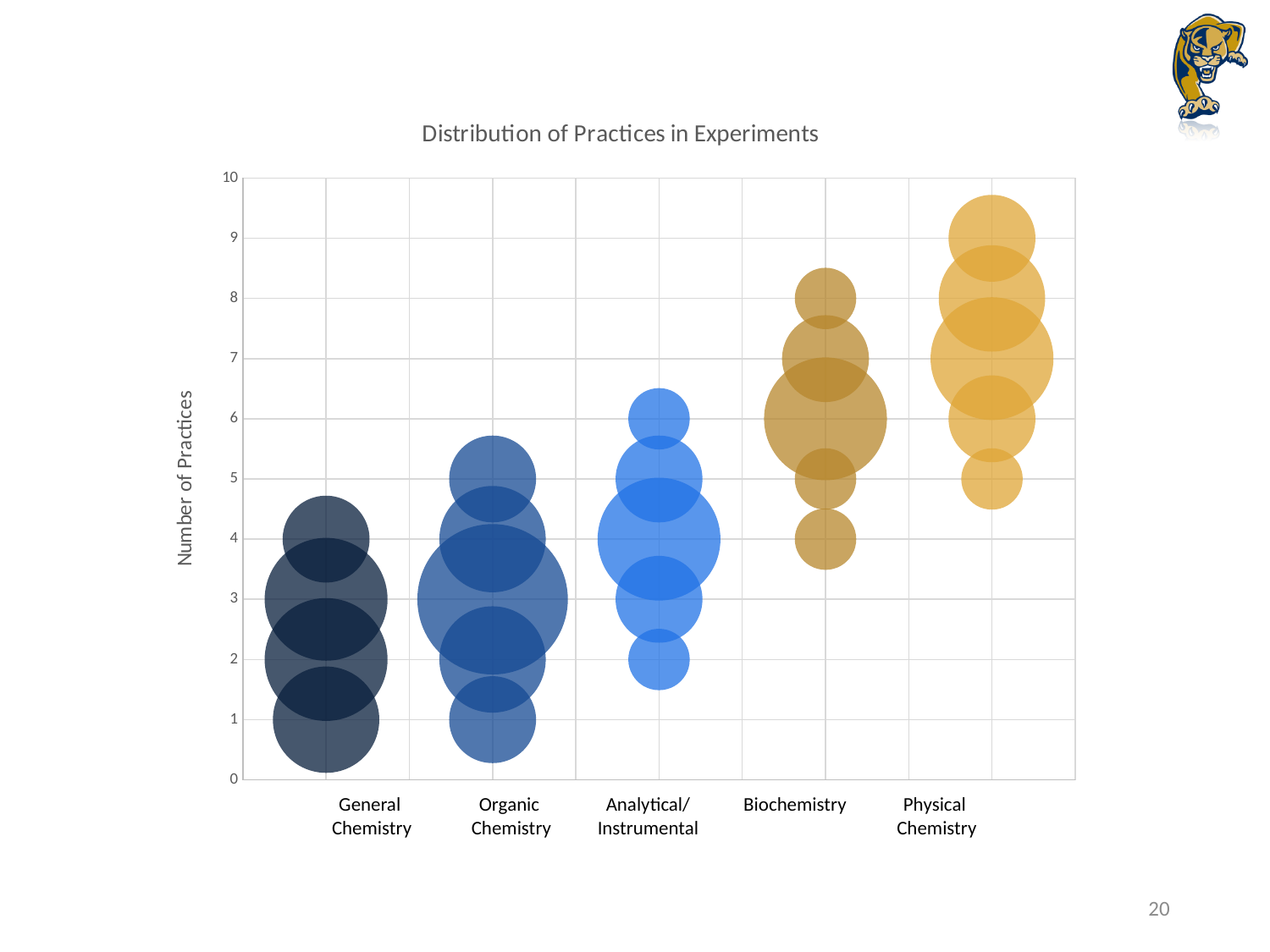
How many bubbles are plotted for Analytical/Instrumental? 5 What is the title of the chart? Distribution of Practices in Experiments What is the highest number of practices at which a bubble is plotted for Biochemistry? 8 Which category has the bubble plotted at the highest number of practices? Physical Chemistry What is the label of the vertical axis? Number of Practices What is the highest number of practices at which a bubble is plotted for Physical Chemistry? 9 How many categories are shown along the x axis of the chart? 5 What is the lowest number of practices at which a bubble is plotted for General Chemistry? 1 Do the bubble positions generally rise or fall moving from General Chemistry to Physical Chemistry along the x axis? rise How many bubbles are plotted for General Chemistry? 4 Is the lowest bubble for Biochemistry plotted at a number of practices greater or less than 3? greater What kind of chart is shown on the slide? bubble chart